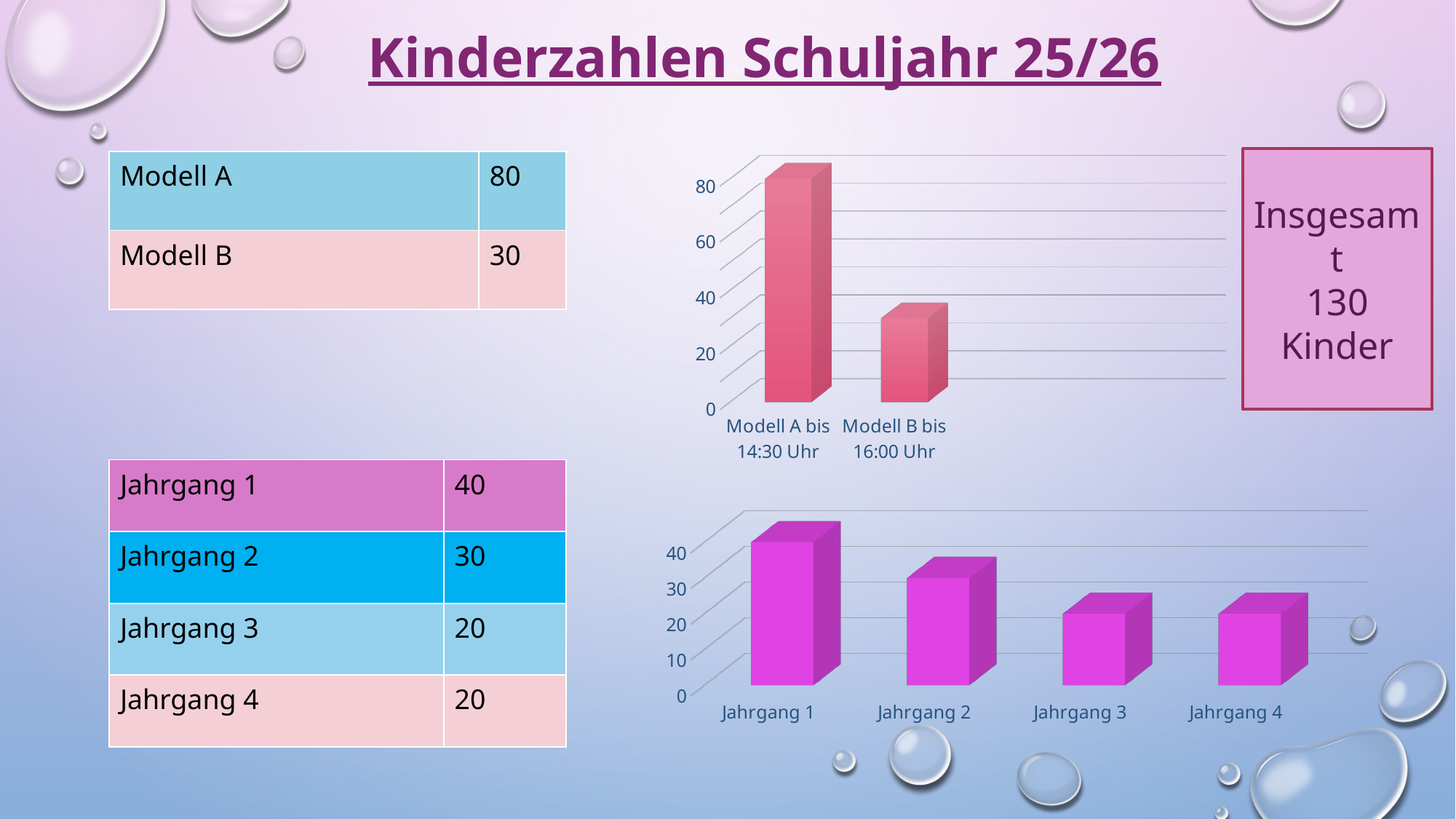
In the bottom chart, how many categories are shown on the x axis? 4 What kind of chart is the top chart? bar chart In the top chart, which category has the highest value? Modell A bis 14:30 Uhr In the top chart, how many bars are plotted? 2 In the top chart, what is the difference between the values for Modell A and Modell B? 50 In the top chart, what is the value for Modell A bis 14:30 Uhr? 80 In the top chart, what is the value for Modell B bis 16:00 Uhr? 30 In the bottom chart, which category has the highest value? Jahrgang 1 In the bottom chart, what is the value for Jahrgang 2? 30 In the bottom chart, what is the value for Jahrgang 1? 40 In the bottom chart, is the value for Jahrgang 3 greater or less than 30? less In the bottom chart, do the values rise or fall from Jahrgang 1 to Jahrgang 3? fall